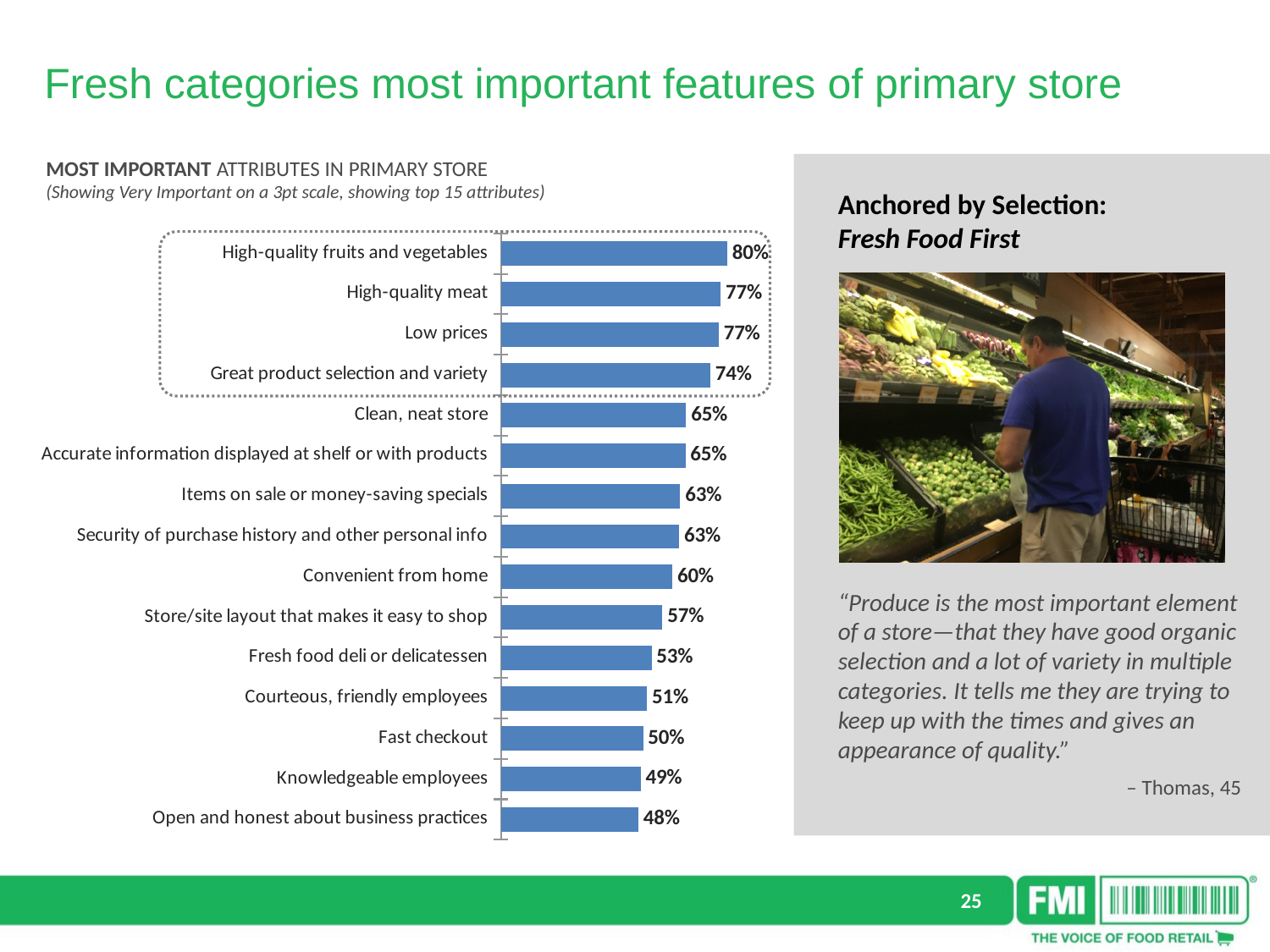
What is the difference between the values for 'High-quality fruits and vegetables' and 'Great product selection and variety'? 6% How many attributes are shown in the chart? 15 What type of chart is shown on the slide? Bar chart Which attribute has the lowest value in the chart? Open and honest about business practices What is the difference between the values for 'Clean, neat store' and 'Fresh food deli or delicatessen'? 12% Which has a higher value, 'Knowledgeable employees' or 'Courteous, friendly employees'? Courteous, friendly employees What is the value shown for 'Fast checkout'? 50% What percentage of respondents rated 'High-quality fruits and vegetables' as very important? 80% How many attributes are enclosed in the dashed box at the top of the chart? 4 Which attribute has the highest value in the chart? High-quality fruits and vegetables Which has a higher value, 'Low prices' or 'Items on sale or money-saving specials'? Low prices What is the value shown for 'Convenient from home'? 60%